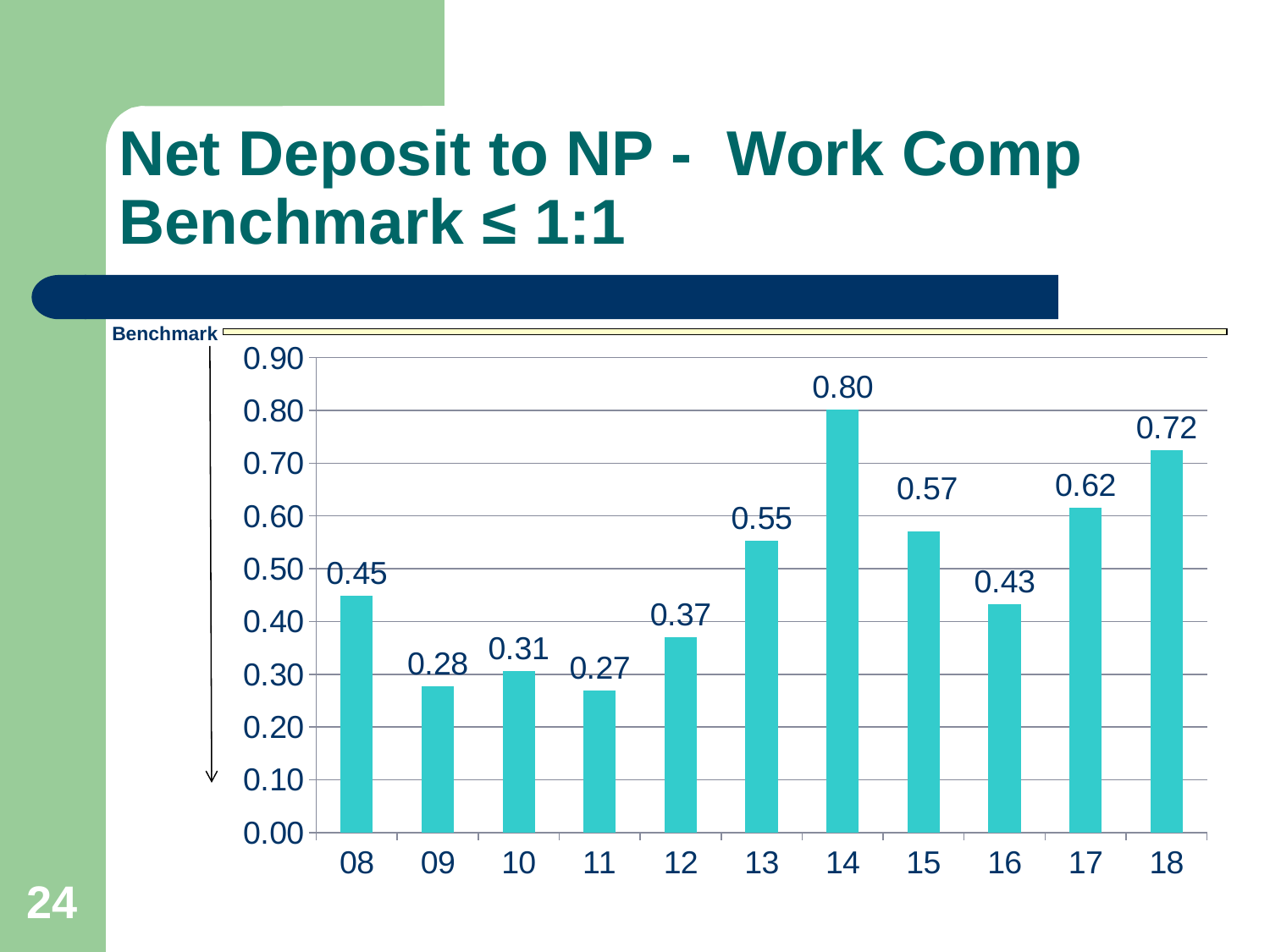
What is the value for 14? 0.80 Do the values rise or fall from 11 to 14? rise What is the value for 18? 0.72 What is the title of the slide? Net Deposit to NP - Work Comp Benchmark ≤ 1:1 What is the difference between the values for 14 and 13? 0.25 Which year has the highest value? 14 Which is larger, the value for 17 or the value for 15? 17 How many years are shown on the x axis? 11 Is the value for 16 greater or less than 0.50? less What kind of chart is shown? bar chart What is the value for 11? 0.27 Which year has the lowest value? 11